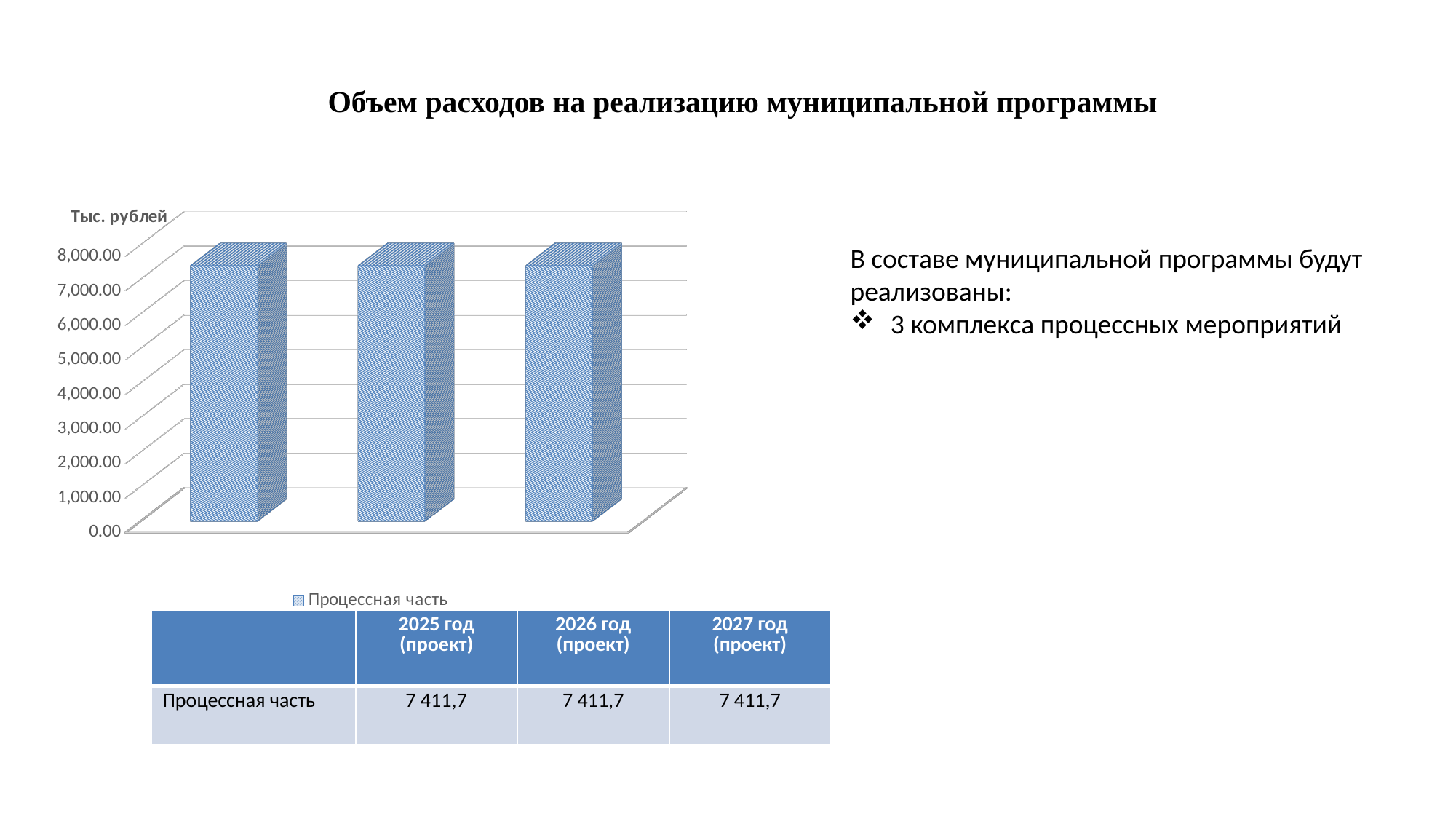
How many bars are plotted in the chart? 3 Do the bar values rise, fall or stay the same from left to right? stay the same What kind of chart is shown on the slide? bar chart Is the value of the first bar greater or less than 7,000.00? greater Is the value of the second bar greater or less than 5,000.00? greater What is the highest tick value shown on the vertical axis of the chart? 8,000.00 According to the table below the chart, what is the value of Процессная часть for 2027 год (проект)? 7 411,7 What is the name of the series shown in the chart legend? Процессная часть Is the value of the third bar greater or less than 8,000.00? less What is the title of the chart on the slide? Объем расходов на реализацию муниципальной программы According to the table below the chart, what is the value of Процессная часть for 2025 год (проект)? 7 411,7 How many series does the chart legend list? 1